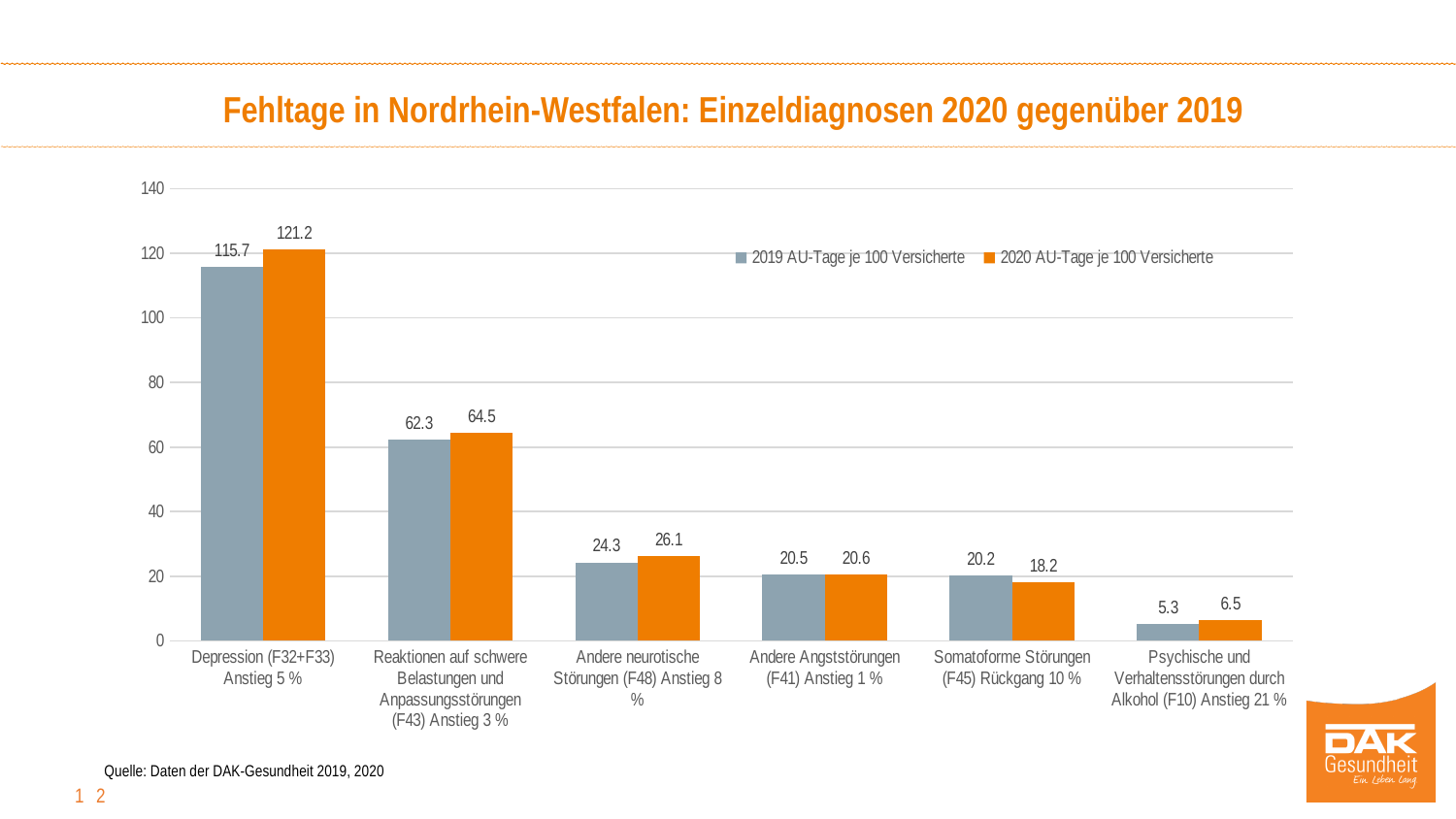
Is the 2019 AU-Tage je 100 Versicherte value for Reaktionen auf schwere Belastungen und Anpassungsstörungen (F43) greater or less than 60? greater What is the 2019 AU-Tage je 100 Versicherte value for Depression (F32+F33)? 115.7 How many diagnosis categories are shown on the x axis? 6 What is the 2020 AU-Tage je 100 Versicherte value for Reaktionen auf schwere Belastungen und Anpassungsstörungen (F43)? 64.5 Which diagnosis has the lowest 2019 AU-Tage je 100 Versicherte value? Psychische und Verhaltensstörungen durch Alkohol (F10) What kind of chart is shown on the slide? Bar chart How many series does the legend list? 2 What is the difference between the 2019 and 2020 AU-Tage je 100 Versicherte values for Somatoforme Störungen (F45)? 2.0 For Andere neurotische Störungen (F48), which is larger: the 2019 or the 2020 AU-Tage je 100 Versicherte value? 2020 What is the difference between the 2020 and 2019 AU-Tage je 100 Versicherte values for Depression (F32+F33)? 5.5 What is the 2020 AU-Tage je 100 Versicherte value for Somatoforme Störungen (F45)? 18.2 Which diagnosis has the highest 2020 AU-Tage je 100 Versicherte value? Depression (F32+F33)